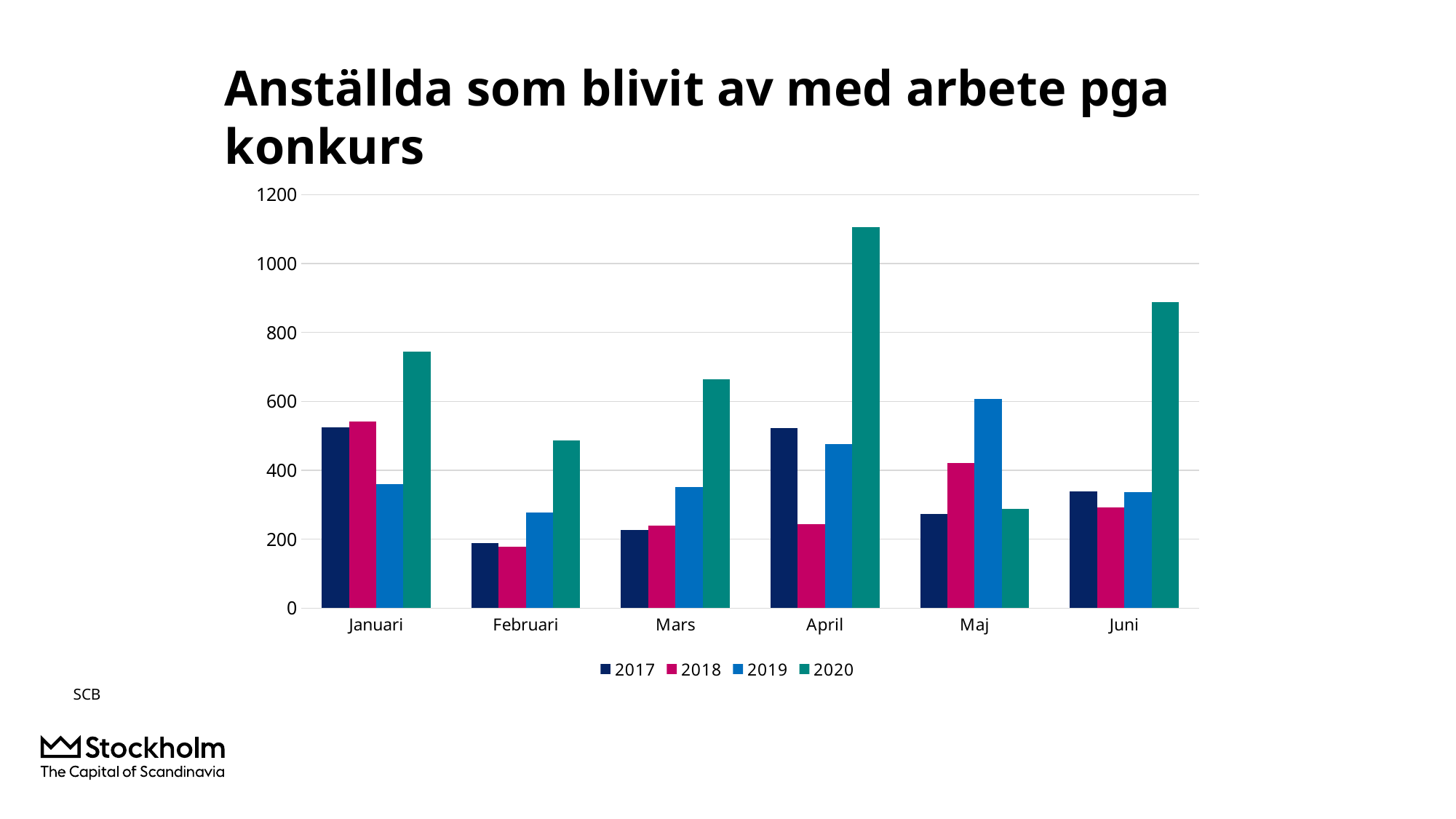
What kind of chart is shown on the slide? bar chart Is the value for 2020 in April greater or less than 1000? greater How many series does the legend list? 4 In Maj, which is larger: the value for 2019 or the value for 2020? 2019 What is the title of the chart? Anställda som blivit av med arbete pga konkurs How many months are shown on the x axis? 6 Which series has the highest value in Januari? 2020 In which month is the value for 2020 highest? April Is the value for 2020 in Juni greater or less than 800? greater In which month is the value for 2020 lowest? Maj Is the value for 2019 in Maj greater or less than 500? greater